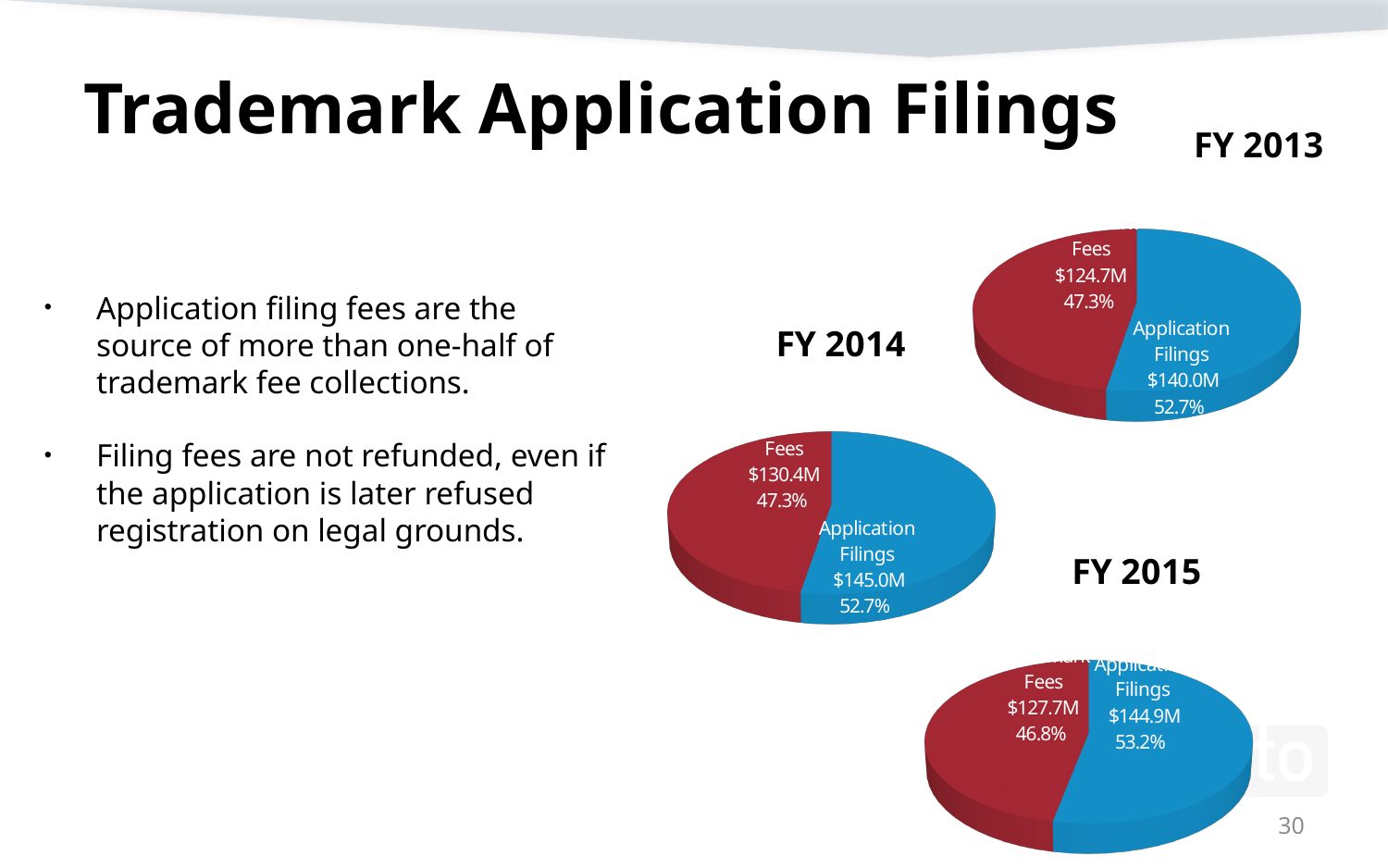
In the FY 2014 pie chart, what is the value for Application Filings? $145.0M In the FY 2015 pie chart, what share of the pie is Application Filings? 53.2% In the FY 2014 pie chart, what is the difference between Application Filings and Fees? $14.6M In the FY 2013 pie chart, what share of the pie is Application Filings? 52.7% In the FY 2013 pie chart, what is the value for Fees? $124.7M In the FY 2015 pie chart, what is the value for Fees? $127.7M In the FY 2013 pie chart, what colour is the Application Filings slice? Blue In the FY 2015 pie chart, which slice is larger, Fees or Application Filings? Application Filings In the FY 2013 pie chart, which slice is the smallest? Fees In the FY 2014 pie chart, what share of the pie is Fees? 47.3% What kind of chart is used for FY 2014? Pie chart How many slices does the FY 2015 pie chart have? 2